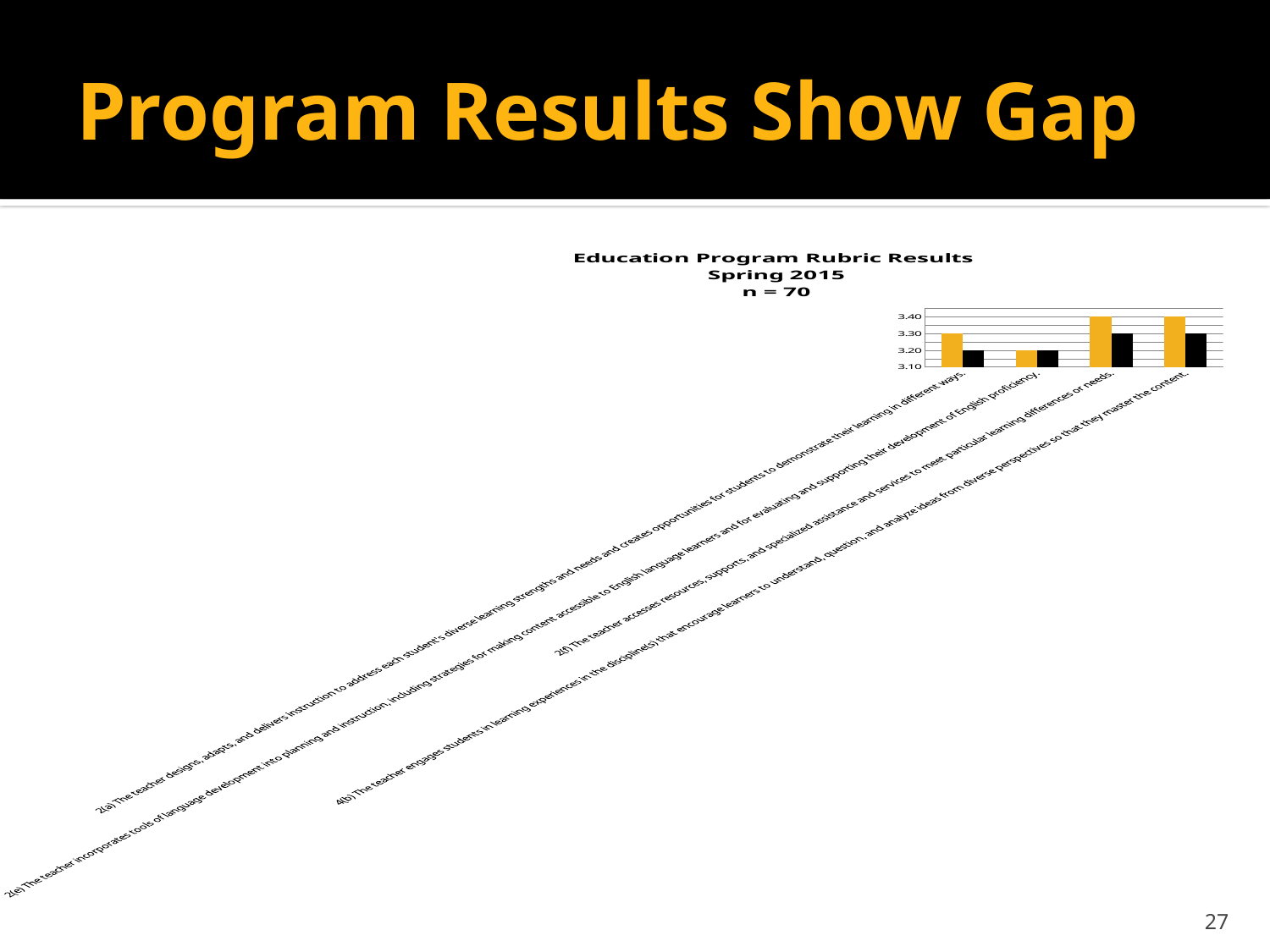
Is the black bar for category 2(a) greater or less than 3.30? less Is the black bar for category 4(b) greater or less than 3.20? greater What two colours are used for the bars in the chart? gold and black Among the gold bars, which category has the lowest value? 2(e) Is the gold bar for category 2(f) greater or less than 3.30? greater What kind of chart is shown on the slide? bar chart Which gold bar is taller, the one for category 2(a) or the one for category 2(f)? 2(f) For category 2(a), which bar is taller, the gold bar or the black bar? gold How many categories (rubric items) are plotted on the x axis of the chart? 4 What sample size (n) is stated in the chart title? n = 70